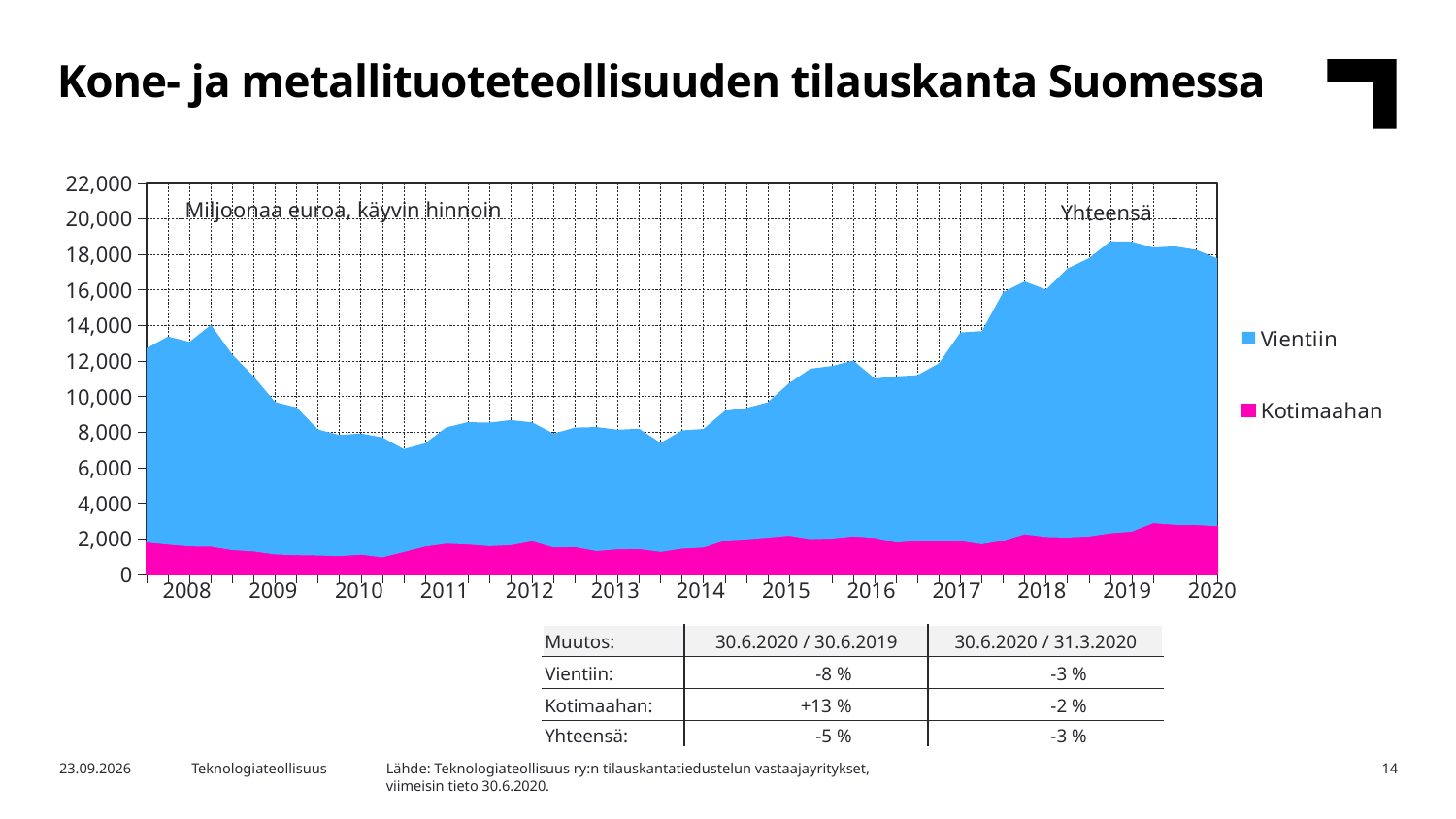
In which year does the total (Yhteensä) reach its highest level? 2019 Is the total value at the start of 2008 greater or less than 10,000? greater Is the Kotimaahan value at any point greater or less than 4,000? less What are the two series named in the chart legend? Vientiin and Kotimaahan Is the total value at its 2019 peak greater or less than 16,000? greater What unit is stated in the note inside the chart area? Miljoonaa euroa, käyvin hinnoin Does the total order backlog rise or fall between 2016 and 2019? rise How many series does the chart legend list? 2 How many year labels are shown on the x axis? 13 Which series is larger throughout the chart, Vientiin or Kotimaahan? Vientiin What kind of chart is shown on the slide? Stacked area chart